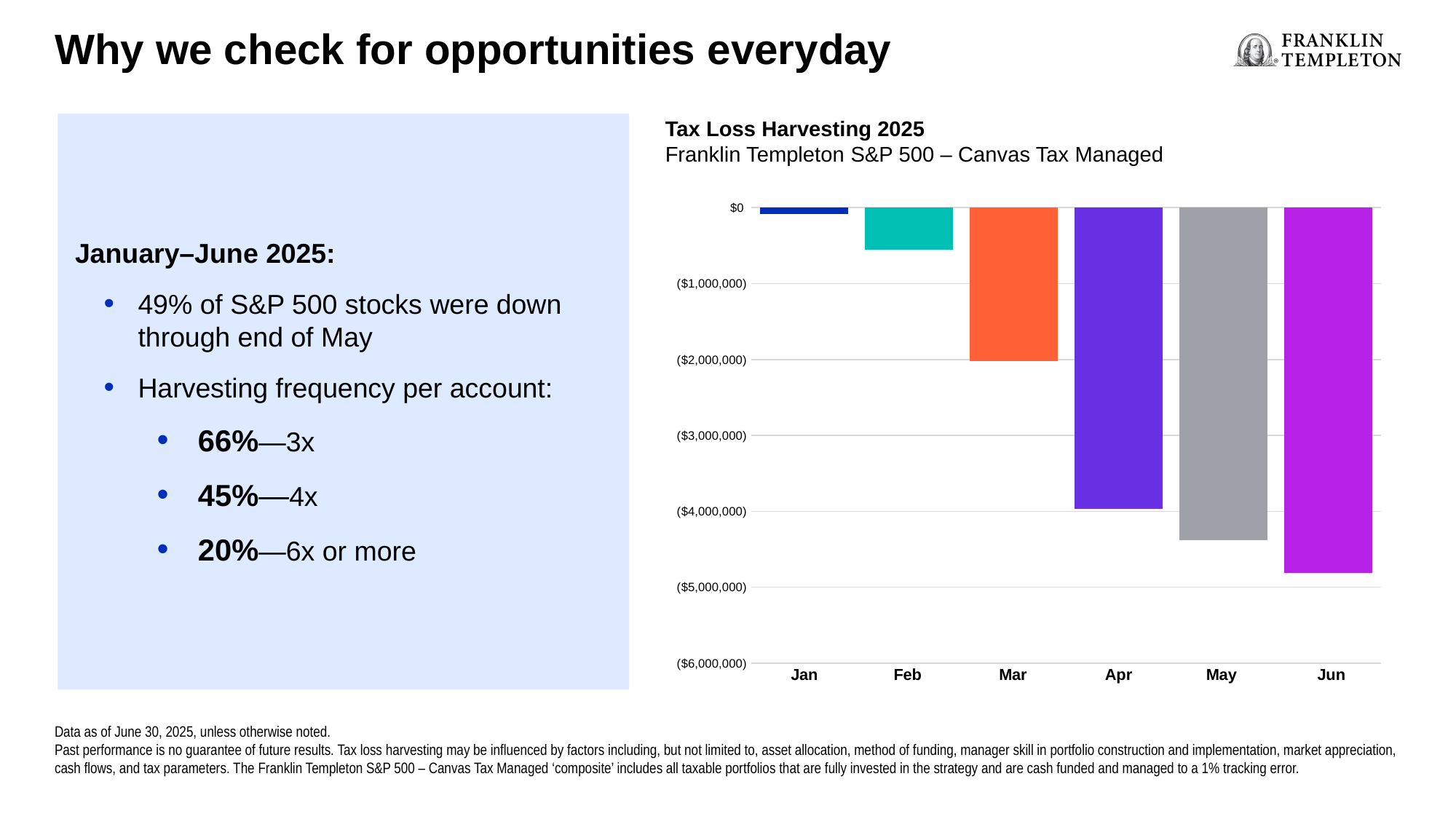
Do the bars get longer or shorter moving from Jan to Jun along the x axis? Longer Which month shows the larger tax loss harvested, May or Jun? Jun Which month shows the larger tax loss harvested, Jan or Feb? Feb What colour is the bar for Mar? Orange Is the value for Feb greater or less than ($1,000,000)? greater Is the value for Apr greater or less than ($3,000,000)? less What kind of chart is shown on the slide? Bar chart Which month shows the smallest tax loss harvested (the shortest bar)? Jan Which month shows the largest tax loss harvested (the longest bar)? Jun How many months are plotted on the chart? 6 What is the title of the chart? Tax Loss Harvesting 2025 Is the value for Jun greater or less than ($5,000,000)? greater